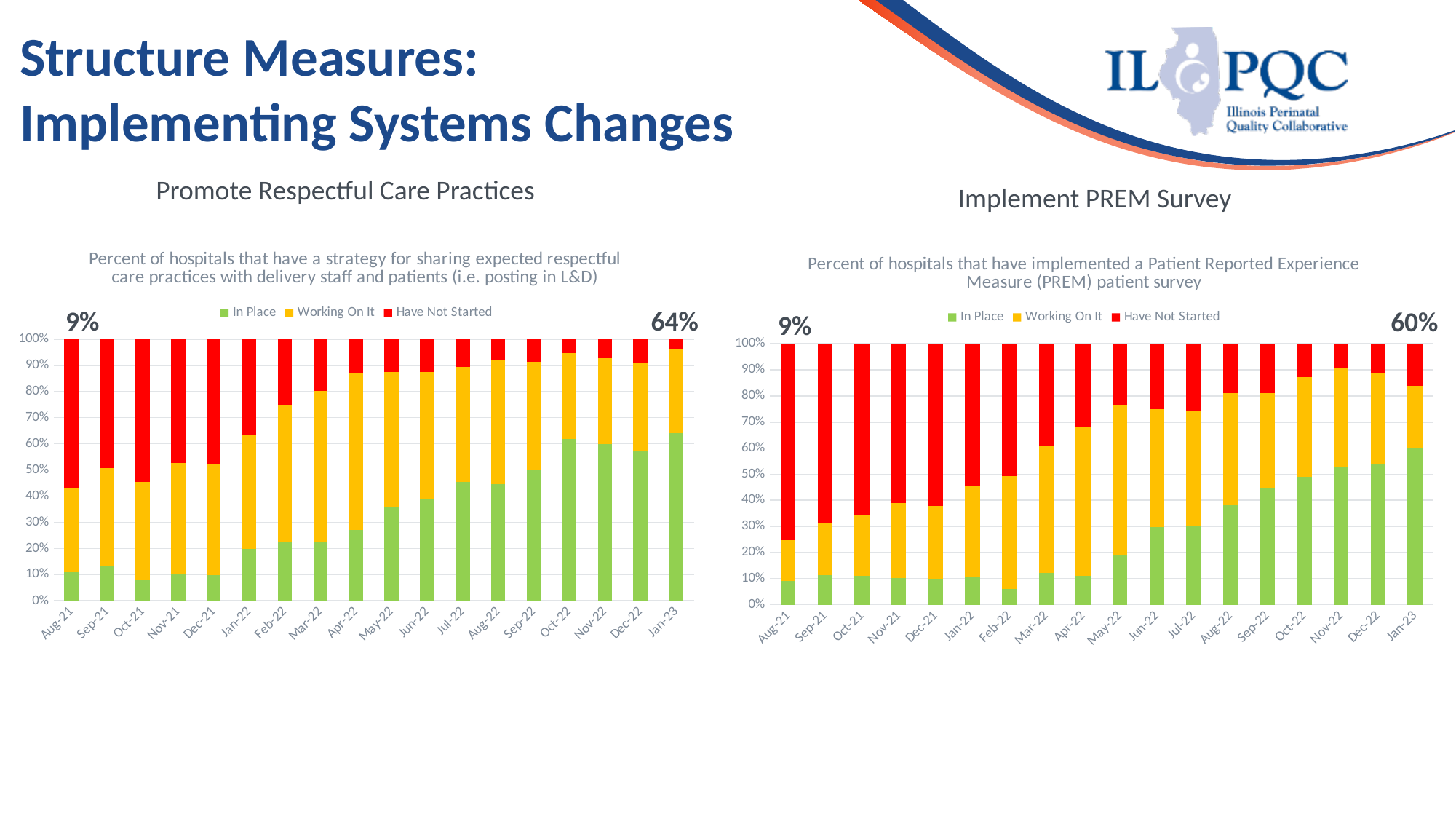
On the Promote Respectful Care Practices chart, what percent of hospitals had the strategy In Place in Aug-21? 9% On the Implement PREM Survey chart, what percent of hospitals had the survey In Place in Aug-21? 9% On the Promote Respectful Care Practices chart, which series is shown in red in the legend? Have Not Started On the Promote Respectful Care Practices chart, what percent of hospitals had the strategy In Place in Jan-23? 64% How many series does the legend of the Implement PREM Survey chart list? 3 How many months are shown on the x axis of the Promote Respectful Care Practices chart? 18 On the Implement PREM Survey chart, what percent of hospitals had the survey In Place in Jan-23? 60% What kind of chart is the Implement PREM Survey chart? Stacked bar chart On the Implement PREM Survey chart, is the Have Not Started share for Aug-21 greater or less than 70%? greater On the Promote Respectful Care Practices chart, by how many percentage points did the In Place share increase from Aug-21 to Jan-23? 55 percentage points On the Promote Respectful Care Practices chart, does the In Place share rise or fall from Aug-21 to Jan-23? Rise Which chart shows a higher In Place percentage in Jan-23, Promote Respectful Care Practices or Implement PREM Survey? Promote Respectful Care Practices